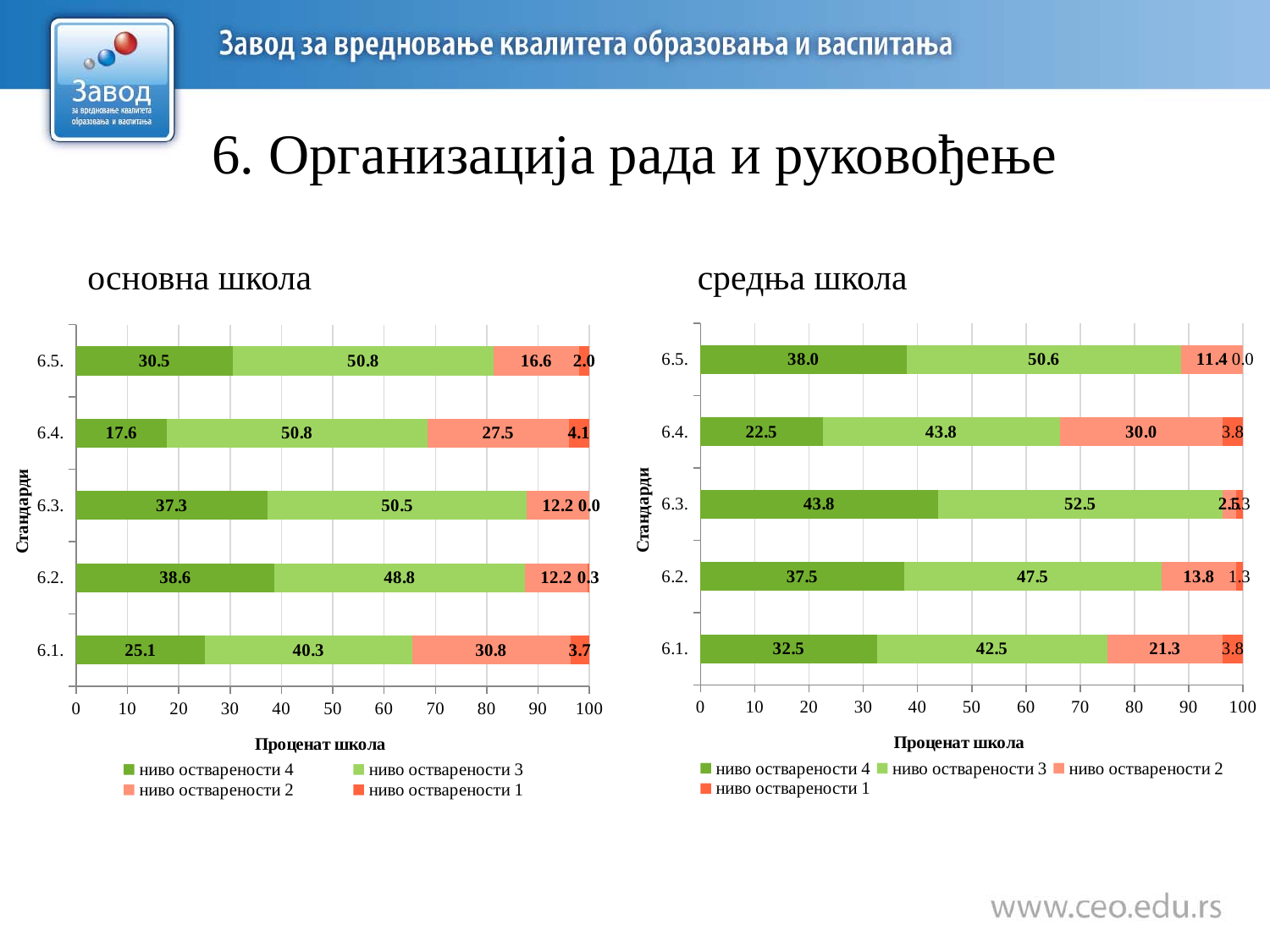
How many series does the legend of the 'средња школа' chart list? 4 In the 'основна школа' chart, which standard has the highest value for 'ниво остварености 4'? 6.2 What type of chart is the 'основна школа' chart? Stacked bar chart In the 'средња школа' chart, which is larger: 'ниво остварености 4' for standard 6.1 or for standard 6.2? 6.2 What is the x-axis title of the 'средња школа' chart? Проценат школа In the 'средња школа' chart, what is the value of 'ниво остварености 3' for standard 6.5? 50.6 In the 'основна школа' chart, what is the difference between the 'ниво остварености 2' values for standards 6.4 and 6.5? 10.9 In the 'средња школа' chart, what is the value of 'ниво остварености 2' for standard 6.4? 30.0 In the 'средња школа' chart, which standard has the lowest value for 'ниво остварености 4'? 6.4 In the 'основна школа' chart, what is the value of 'ниво остварености 4' for standard 6.2? 38.6 In the 'основна школа' chart, what is the value of 'ниво остварености 2' for standard 6.1? 30.8 How many standards (categories) are shown in the 'основна школа' chart? 5